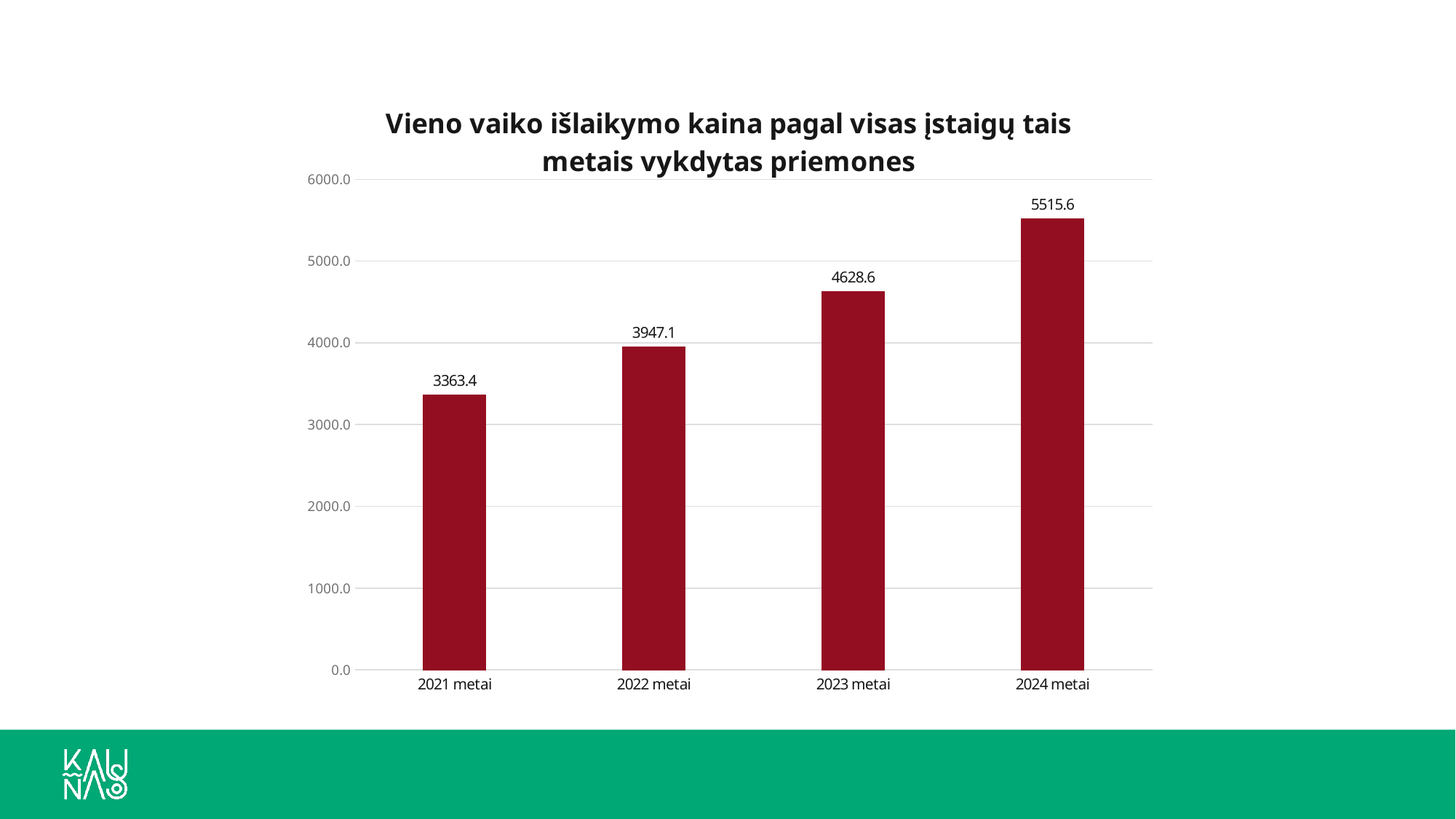
Which year has the lowest value? 2021 metai Which is larger, the value for 2022 metai or 2023 metai? 2023 metai What kind of chart is shown on the slide? Bar chart What is the difference between the values for 2023 metai and 2022 metai? 681.5 What is the difference between the values for 2024 metai and 2021 metai? 2152.2 What is the value for 2024 metai? 5515.6 What is the value for 2023 metai? 4628.6 What is the value for 2022 metai? 3947.1 What is the value for 2021 metai? 3363.4 How many years are shown on the x axis? 4 Is the value for 2024 metai greater or less than 5000.0? greater Which year has the highest value? 2024 metai